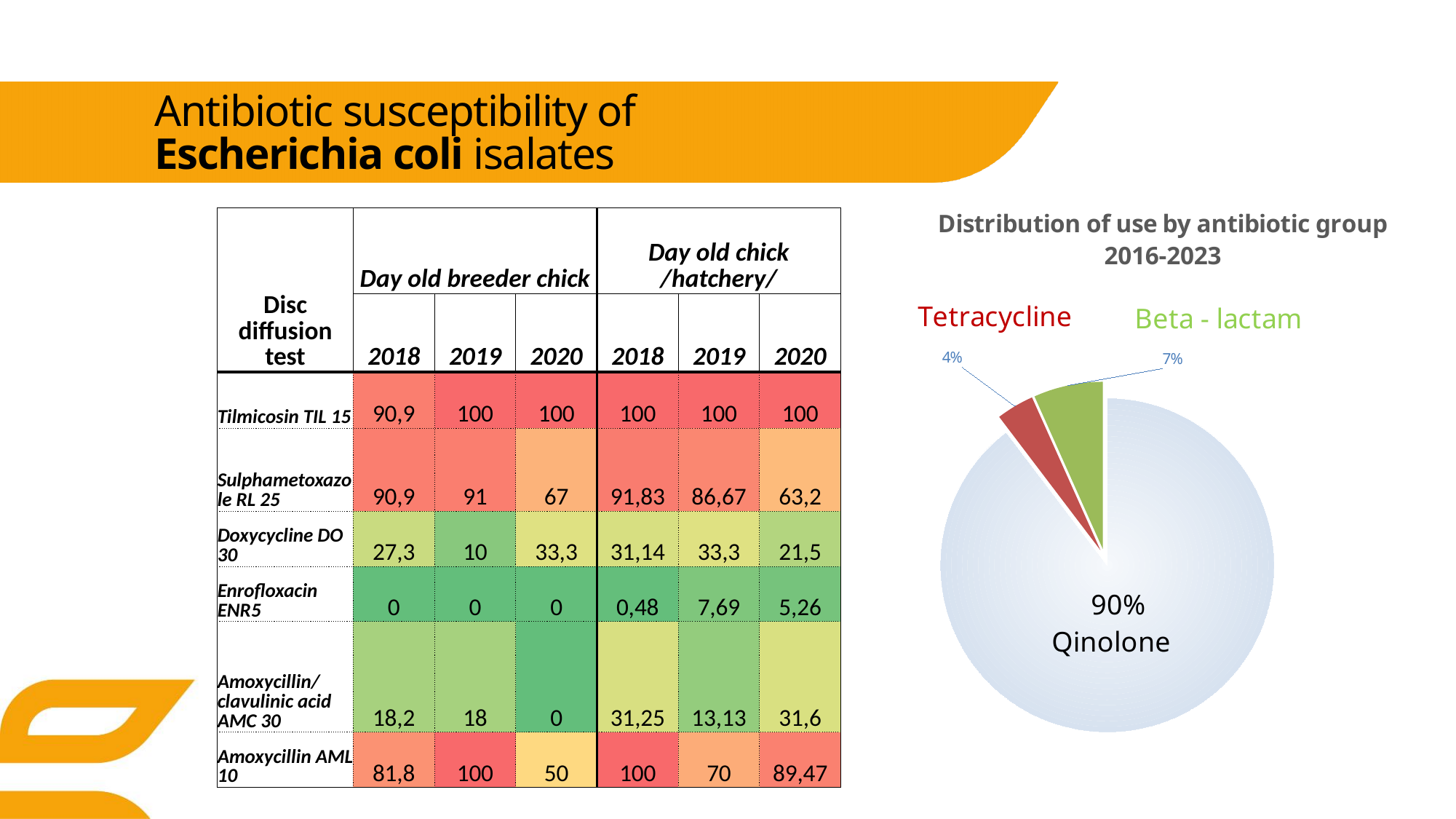
What colour is the Tetracycline slice in the pie chart? Red Which antibiotic group has the largest slice in the pie chart? Qinolone What kind of chart is shown on the right of the slide? Pie chart Which antibiotic group has the smallest slice in the pie chart? Tetracycline In the pie chart, what share of use does Qinolone account for? 90% What is the title of the pie chart? Distribution of use by antibiotic group 2016-2023 In the pie chart, which slice is larger: Beta - lactam or Tetracycline? Beta - lactam In the pie chart, what is the difference in percentage points between the Beta - lactam and Tetracycline shares? 3% In the pie chart, what is the difference in percentage points between the Qinolone and Beta - lactam shares? 83% In the pie chart, what share of use does Tetracycline account for? 4% How many antibiotic groups are shown in the pie chart? 3 In the pie chart, what share of use does Beta - lactam account for? 7%